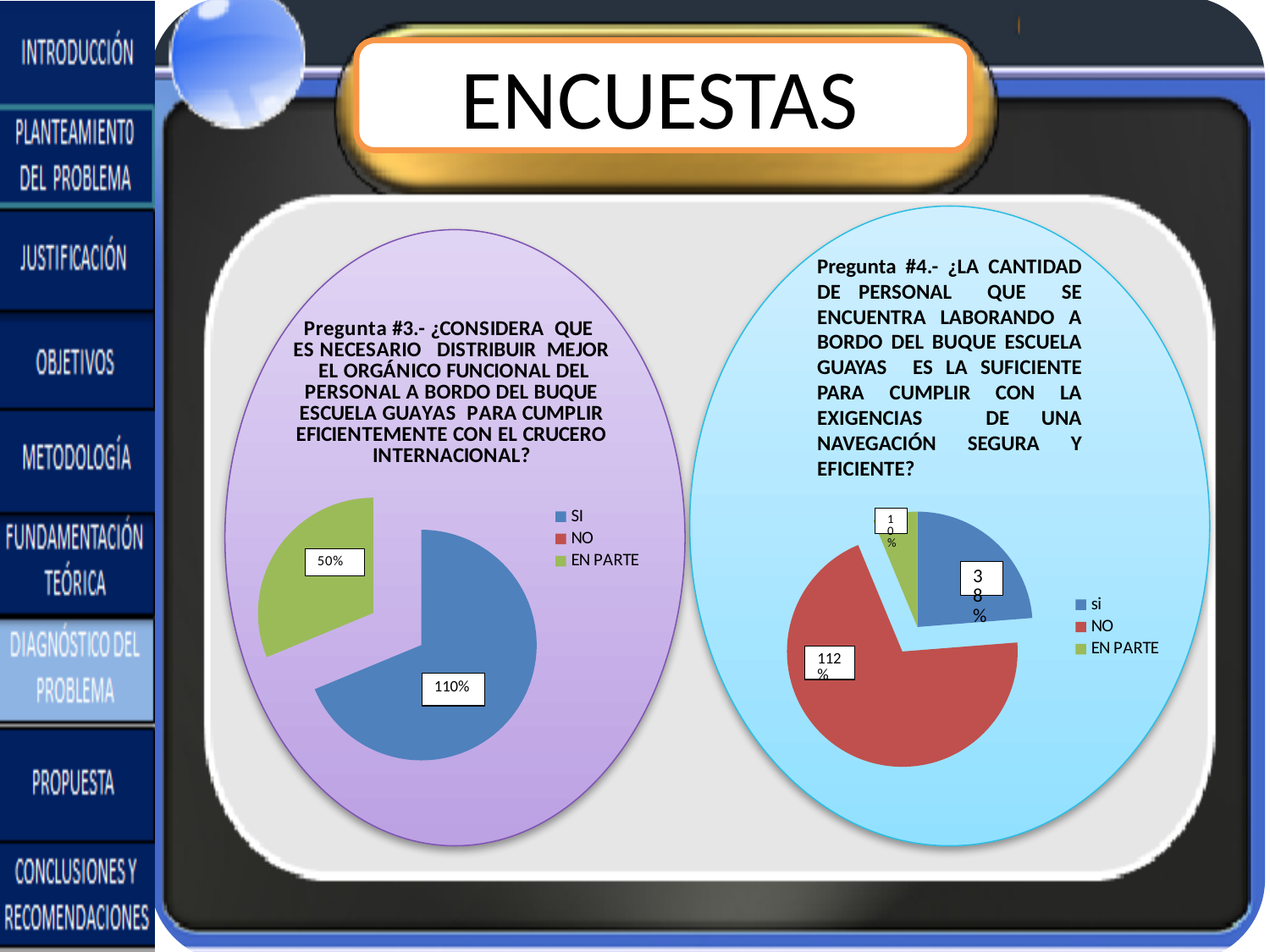
In the Pregunta #4 chart on the right, which category has the smallest slice? EN PARTE In the Pregunta #4 chart on the right, what value is labelled on the NO slice? 112% How many entries does the legend of the Pregunta #3 chart on the left list? 3 In the Pregunta #4 chart on the right, what value is labelled on the si slice? 38% In the Pregunta #3 chart on the left, what value is labelled on the SI slice? 110% In the Pregunta #3 chart on the left, what value is labelled on the EN PARTE slice? 50% What kind of chart is shown for Pregunta #3 on the left? pie chart In the Pregunta #4 chart on the right, what value is labelled on the EN PARTE slice? 10% In the Pregunta #4 chart on the right, which category has the largest slice? NO In the Pregunta #3 chart on the left, which is larger, SI or EN PARTE? SI In the Pregunta #3 chart on the left, which category has the largest slice? SI In the Pregunta #4 chart on the right, what is the difference between the NO value and the si value? 74%